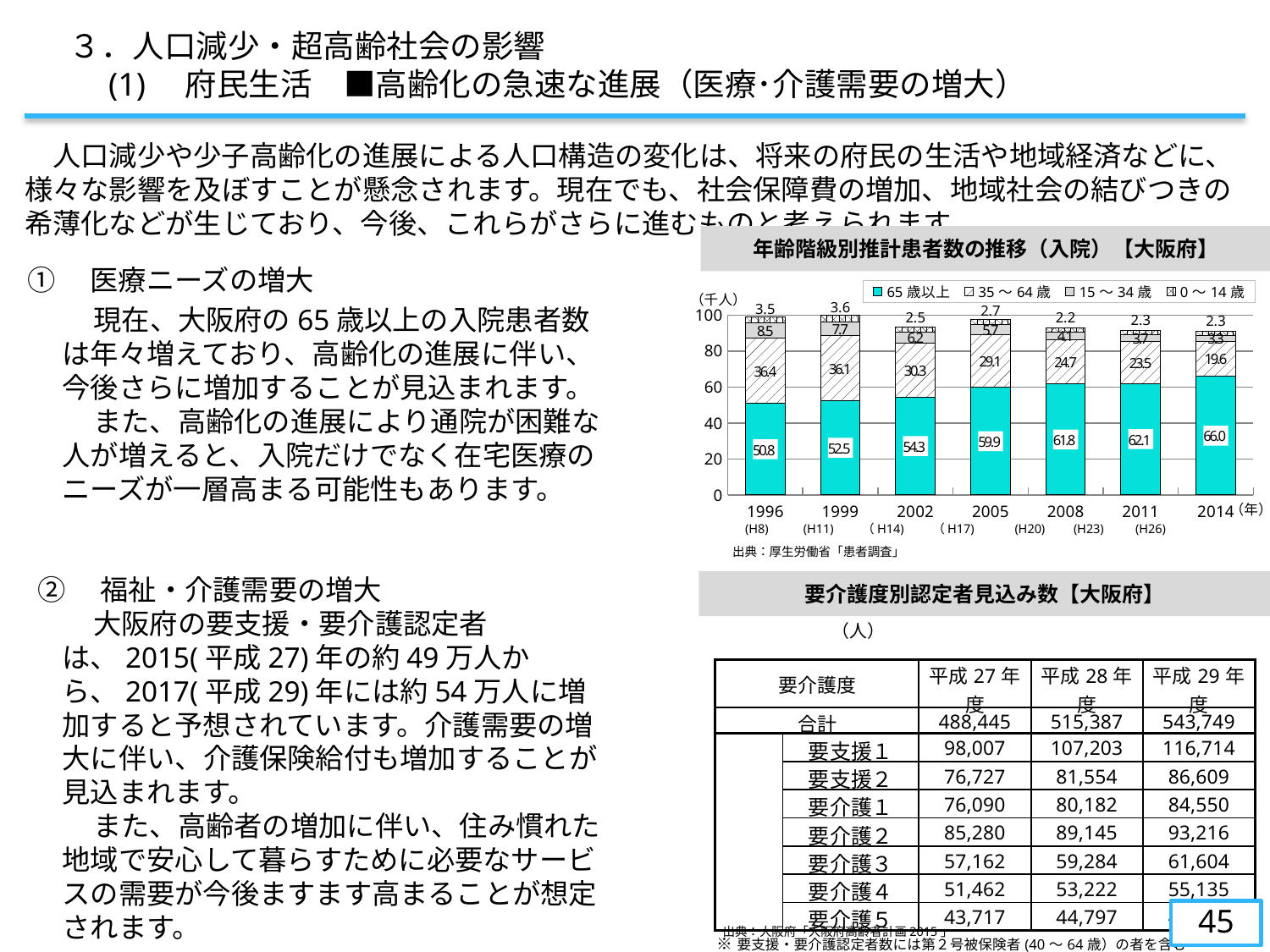
In the 年齢階級別推計患者数の推移（入院）【大阪府】 chart, what is the value for 65歳以上 in 2005? 59.9 In the 年齢階級別推計患者数の推移（入院）【大阪府】 chart, which year has the highest value for 65歳以上? 2014 In the 年齢階級別推計患者数の推移（入院）【大阪府】 chart, what is the difference between the 65歳以上 values for 2014 and 1996? 15.2 What type of chart is the 年齢階級別推計患者数の推移（入院）【大阪府】 chart? stacked bar chart In the 年齢階級別推計患者数の推移（入院）【大阪府】 chart, what is the value for 65歳以上 in 2014? 66.0 What is the unit shown on the y axis of the 年齢階級別推計患者数の推移（入院）【大阪府】 chart? 千人 In the 年齢階級別推計患者数の推移（入院）【大阪府】 chart, is the 65歳以上 value larger in 2008 or in 2002? 2008 In the 年齢階級別推計患者数の推移（入院）【大阪府】 chart, what is the value for 35～64歳 in 1996? 36.4 In the 年齢階級別推計患者数の推移（入院）【大阪府】 chart, how many years are shown on the x axis? 7 In the 年齢階級別推計患者数の推移（入院）【大阪府】 chart, does the 35～64歳 value rise or fall from 1996 to 2014? fall In the 年齢階級別推計患者数の推移（入院）【大阪府】 chart, which year has the lowest value for 35～64歳? 2014 How many series does the legend of the 年齢階級別推計患者数の推移（入院）【大阪府】 chart list? 4